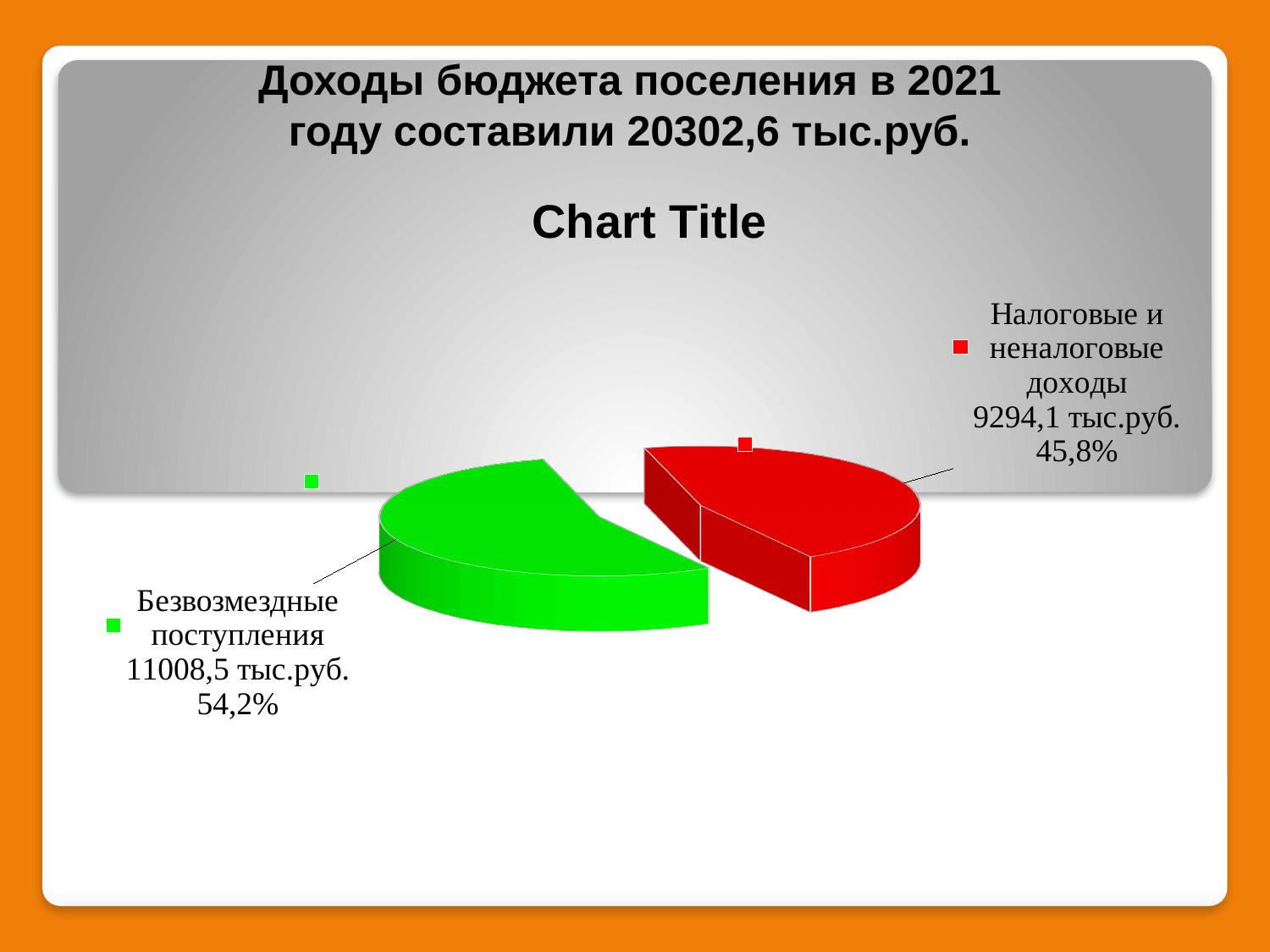
Which slice is the smallest? Налоговые и неналоговые доходы What is the value for Безвозмездные поступления? 11008,5 тыс.руб. Which slice is the largest? Безвозмездные поступления What is the difference between Безвозмездные поступления and Налоговые и неналоговые доходы in тыс.руб.? 1714,4 тыс.руб. What kind of chart is shown on the slide? pie chart How many slices does the pie chart have? 2 What is the value for Налоговые и неналоговые доходы? 9294,1 тыс.руб. What is the title shown above the pie chart? Chart Title What share of the pie does Безвозмездные поступления represent? 54,2% What share of the pie does Налоговые и неналоговые доходы represent? 45,8% What colour is the slice for Безвозмездные поступления? green Which is larger: Безвозмездные поступления or Налоговые и неналоговые доходы? Безвозмездные поступления